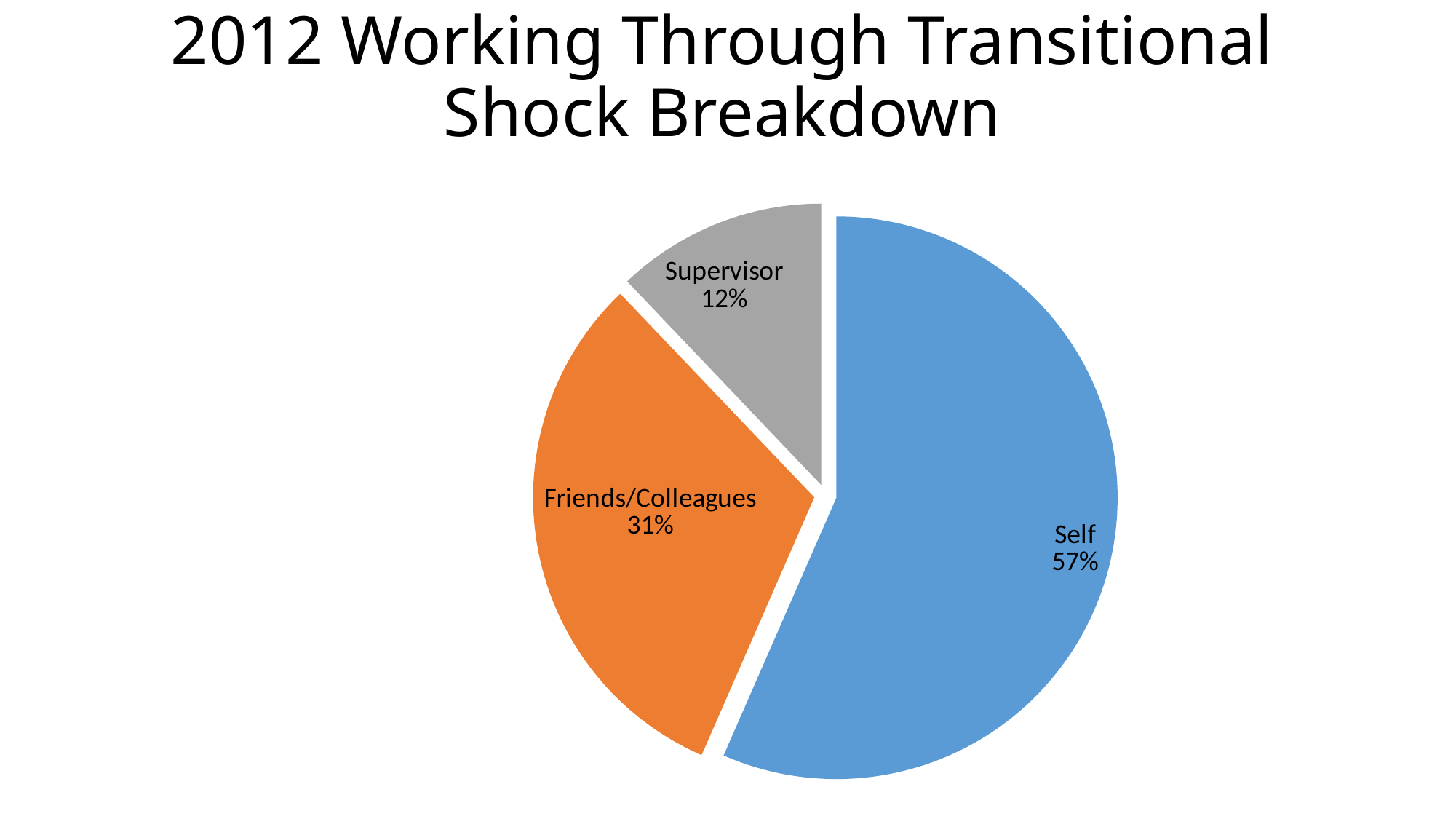
What percentage is shown for Supervisor? 12% Which category has the largest share of the pie? Self What percentage is shown for Friends/Colleagues? 31% Which is larger, the share for Friends/Colleagues or the share for Supervisor? Friends/Colleagues What is the difference in percentage points between Friends/Colleagues and Supervisor? 19 What kind of chart is shown on the slide? pie chart What percentage is shown for Self? 57% What colour is the Self slice? blue What is the difference in percentage points between Self and Friends/Colleagues? 26 How many slices does the pie chart have? 3 What is the title of the chart? 2012 Working Through Transitional Shock Breakdown Which category has the smallest share of the pie? Supervisor